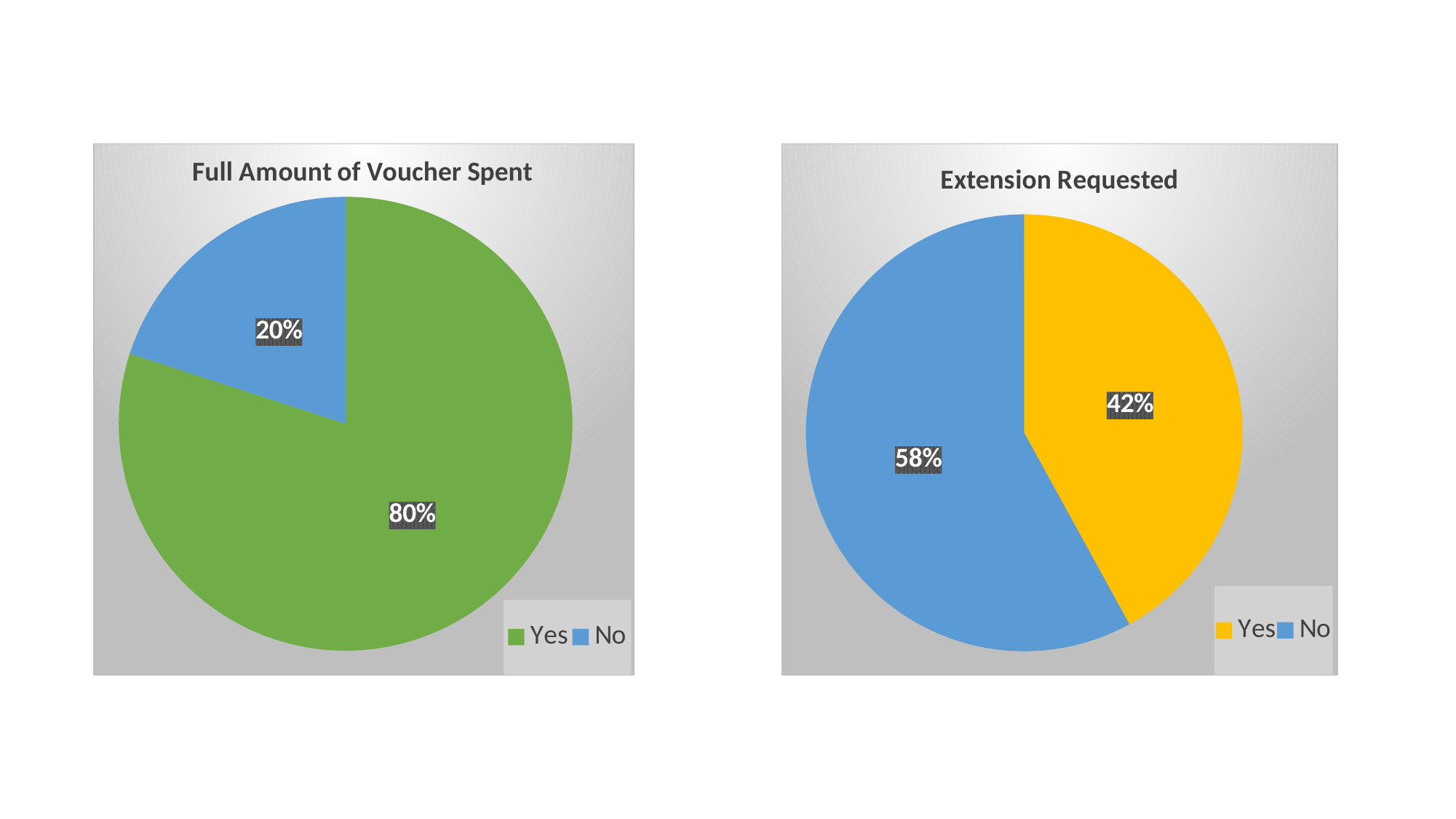
In the 'Extension Requested' chart, which is larger, 'Yes' or 'No'? No In the 'Extension Requested' chart, what is the difference between the 'No' and 'Yes' shares? 16% In the 'Full Amount of Voucher Spent' chart, what share of the pie is 'No'? 20% What kind of chart is the 'Full Amount of Voucher Spent' chart? Pie chart In the 'Extension Requested' chart, what share of the pie is 'Yes'? 42% How many slices does the 'Extension Requested' pie chart have? 2 In the 'Full Amount of Voucher Spent' chart, what is the difference between the 'Yes' and 'No' shares? 60% In the 'Extension Requested' chart, what share of the pie is 'No'? 58% In the 'Full Amount of Voucher Spent' chart, which category has the largest slice? Yes In the 'Extension Requested' chart, which category has the smallest slice? Yes In the 'Extension Requested' chart, what colour is the 'Yes' slice? Yellow